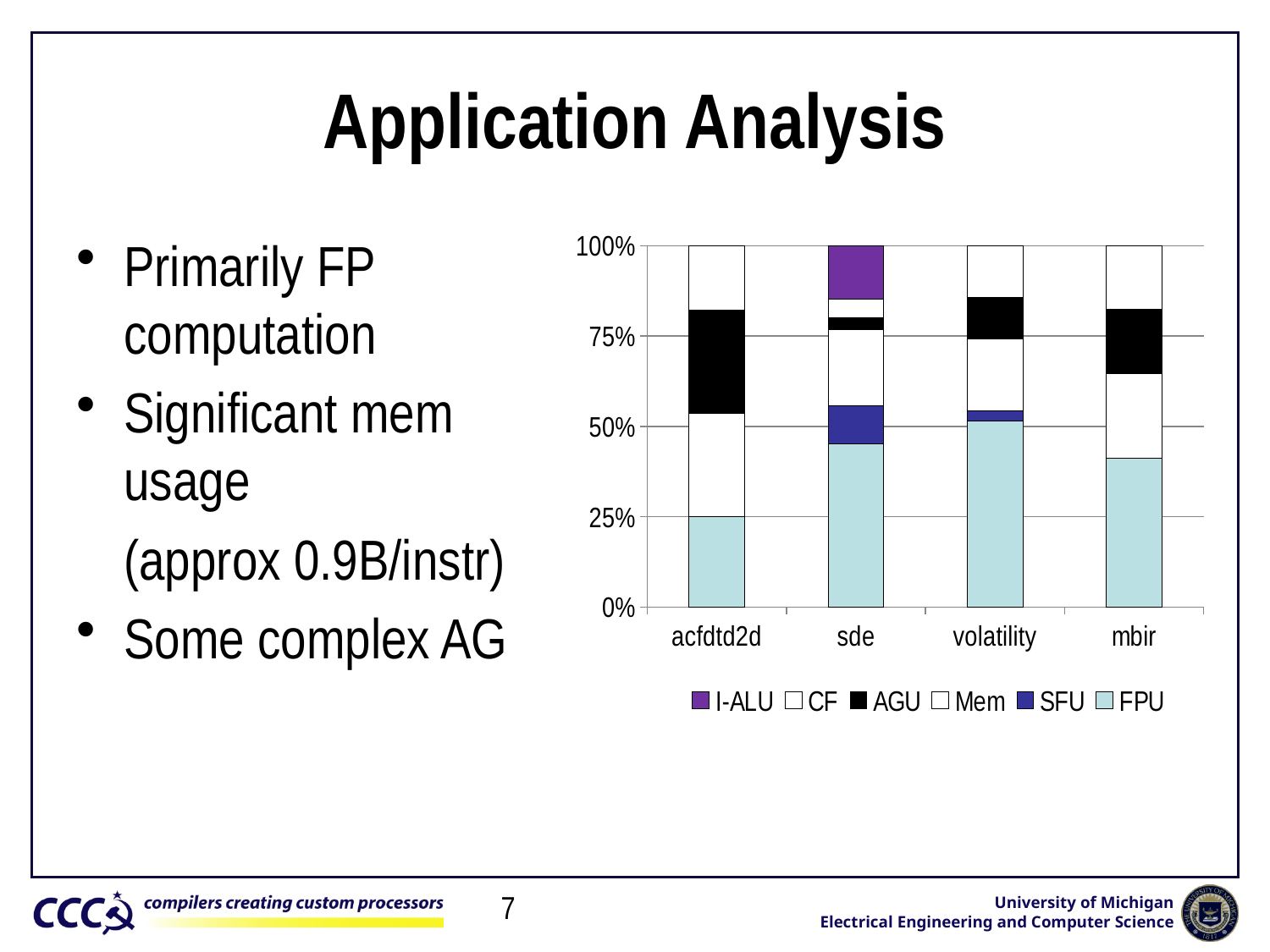
How many series does the chart legend list? 6 Which application has the largest FPU share in the chart? volatility Is the FPU share for mbir greater or less than 50%? less What kind of chart is shown on the slide? stacked bar chart Which application has the smallest FPU share in the chart? acfdtd2d Which application has a larger FPU share, acfdtd2d or mbir? mbir Which application has the largest AGU segment in the chart? acfdtd2d How many applications (categories) are shown on the x axis of the chart? 4 Which application has the smallest AGU segment in the chart? sde Is the FPU share for sde greater or less than 50%? less Which application is the only one with a visible I-ALU segment in the chart? sde What is the total height of each stacked bar in the chart? 100%